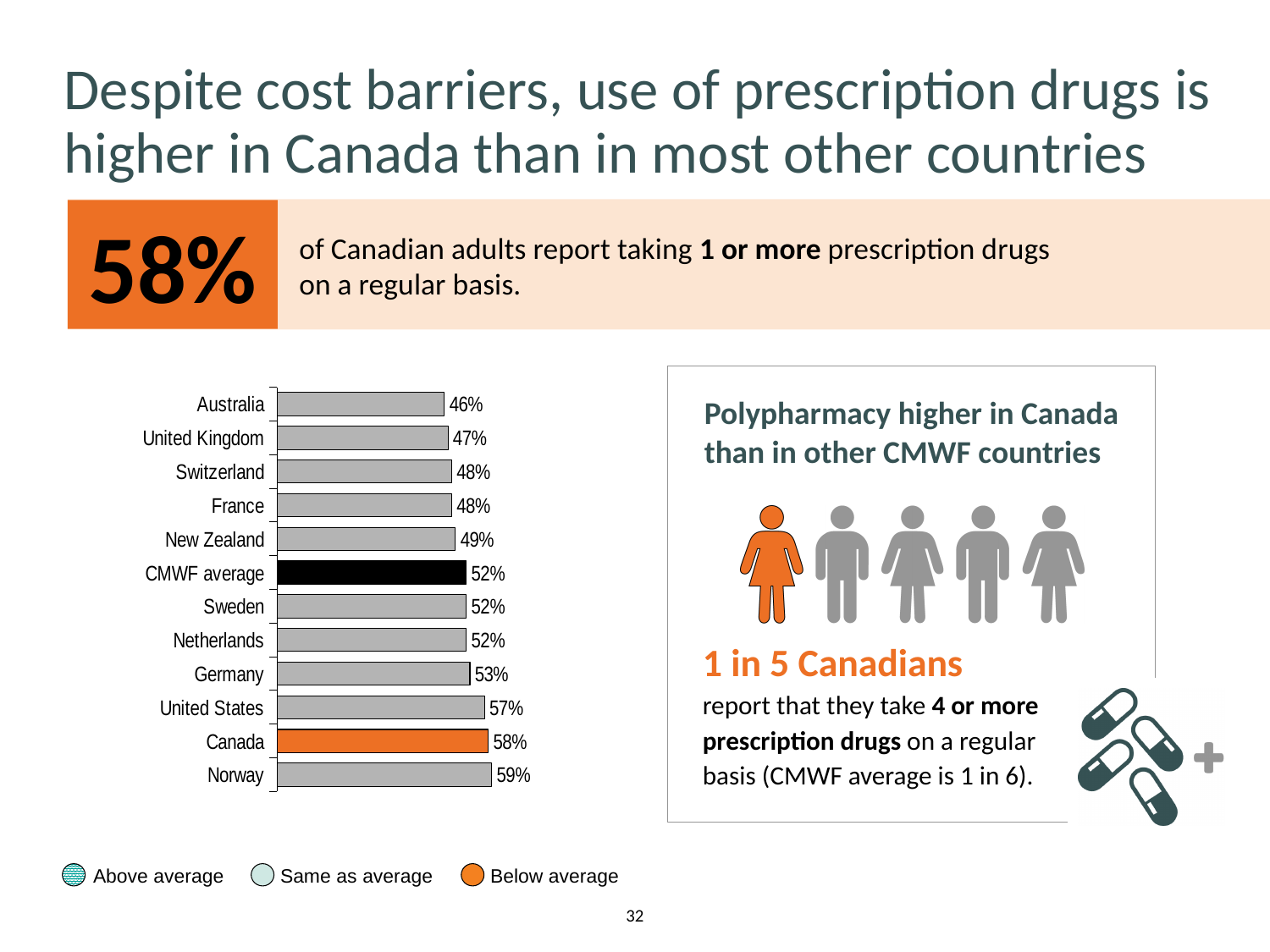
How many bars are shown in the bar chart, including the CMWF average? 12 What is the difference between the values for Canada and the CMWF average? 6% What kind of chart is shown on the slide? Bar chart Which has a larger value, the United States or Germany? United States What is the value for Australia in the bar chart? 46% Which country has the lowest value in the bar chart? Australia What is the value for New Zealand in the bar chart? 49% What is the value for Canada in the bar chart? 58% Which country has the highest value in the bar chart? Norway What colour is the bar for Canada in the bar chart? Orange What is the value for the CMWF average in the bar chart? 52% What is the difference between the values for Norway and Australia? 13%